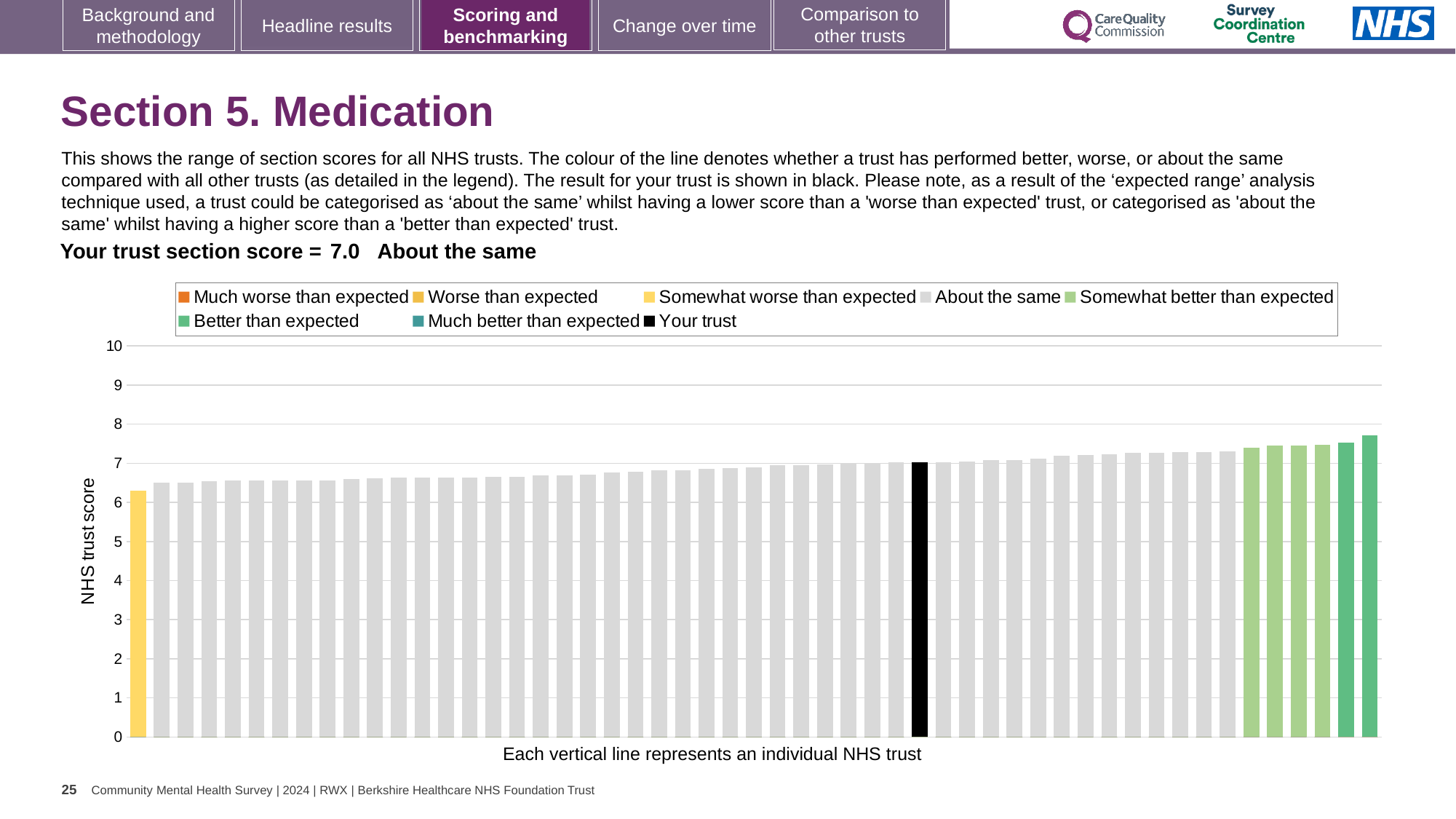
Do the trust scores rise or fall moving from left to right along the x axis? rise What is the label on the vertical axis of the chart? NHS trust score What kind of chart is shown on the slide? bar chart Is the score of the lowest (leftmost, yellow) bar greater or less than 7? less Which performance category is your trust placed in for Section 5. Medication? About the same How many entries does the chart legend list? 8 Is the score of the highest (rightmost) bar greater or less than 8? less What is the section score for your trust shown on the slide? 7.0 Which legend category does the lowest-scoring trust bar belong to? Somewhat worse than expected How many bars are coloured as 'Better than expected' (the darker green bars)? 2 Is the black bar for your trust higher or lower than the yellow bar? higher Is the score of the highest (rightmost) bar greater or less than 7? greater